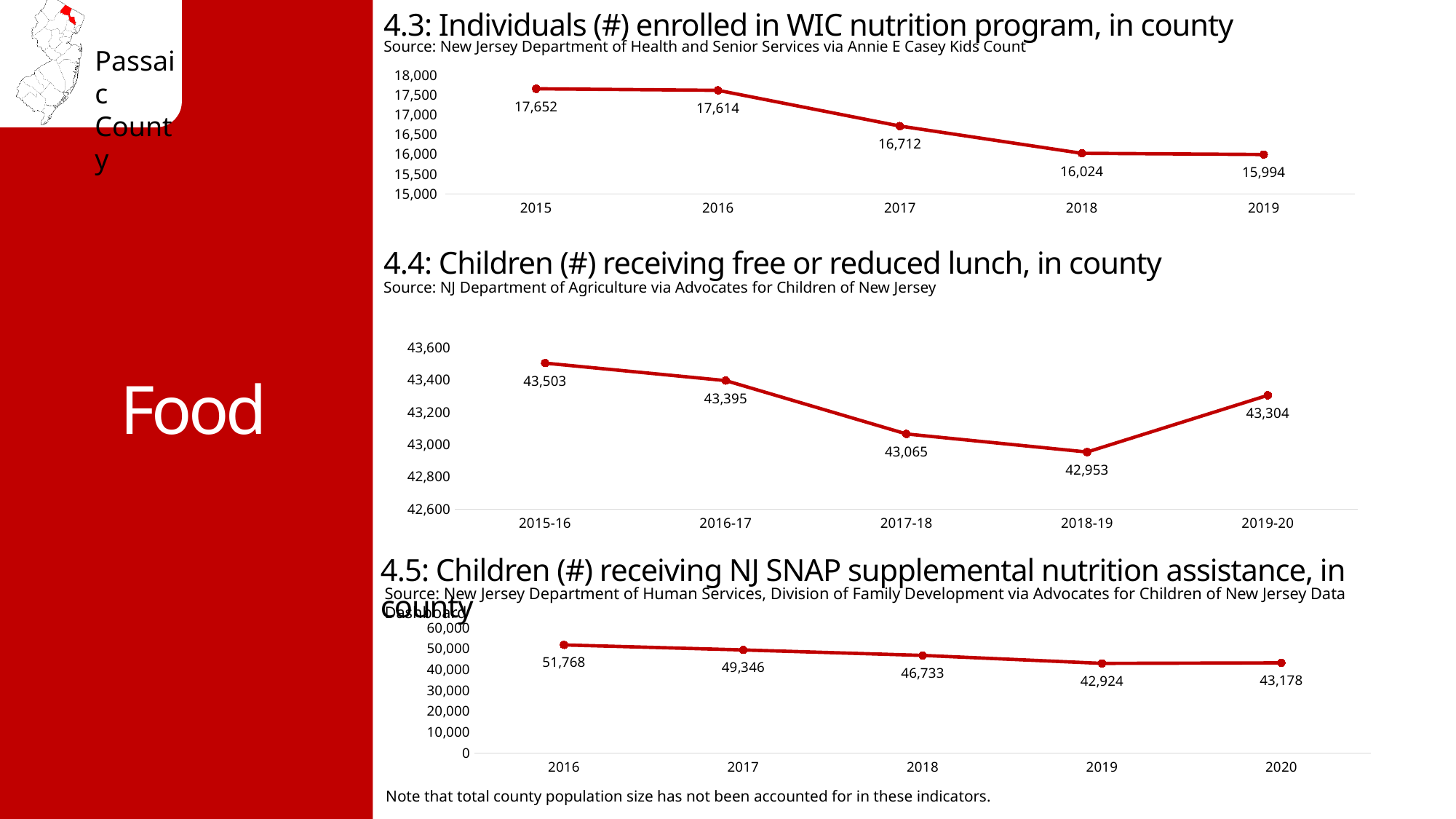
In the chart '4.3: Individuals (#) enrolled in WIC nutrition program, in county', what is the value for 2017? 16,712 In the chart '4.5: Children (#) receiving NJ SNAP supplemental nutrition assistance, in county', what is the value for 2016? 51,768 In the chart '4.5: Children (#) receiving NJ SNAP supplemental nutrition assistance, in county', what is the difference between the 2017 and 2018 values? 2,613 In the chart '4.3: Individuals (#) enrolled in WIC nutrition program, in county', which year has the lowest value? 2019 In the chart '4.4: Children (#) receiving free or reduced lunch, in county', what is the value for 2018-19? 42,953 In the chart '4.3: Individuals (#) enrolled in WIC nutrition program, in county', what is the difference between the 2015 and 2019 values? 1,658 In the chart '4.5: Children (#) receiving NJ SNAP supplemental nutrition assistance, in county', which year has the lowest value? 2019 In the chart '4.4: Children (#) receiving free or reduced lunch, in county', how many data points are plotted? 5 What type of chart is '4.5: Children (#) receiving NJ SNAP supplemental nutrition assistance, in county'? line chart In the chart '4.4: Children (#) receiving free or reduced lunch, in county', which is larger, the value for 2016-17 or the value for 2019-20? 2016-17 In the chart '4.3: Individuals (#) enrolled in WIC nutrition program, in county', do the values generally rise or fall from 2015 to 2019? fall In the chart '4.4: Children (#) receiving free or reduced lunch, in county', which school year has the highest value? 2015-16